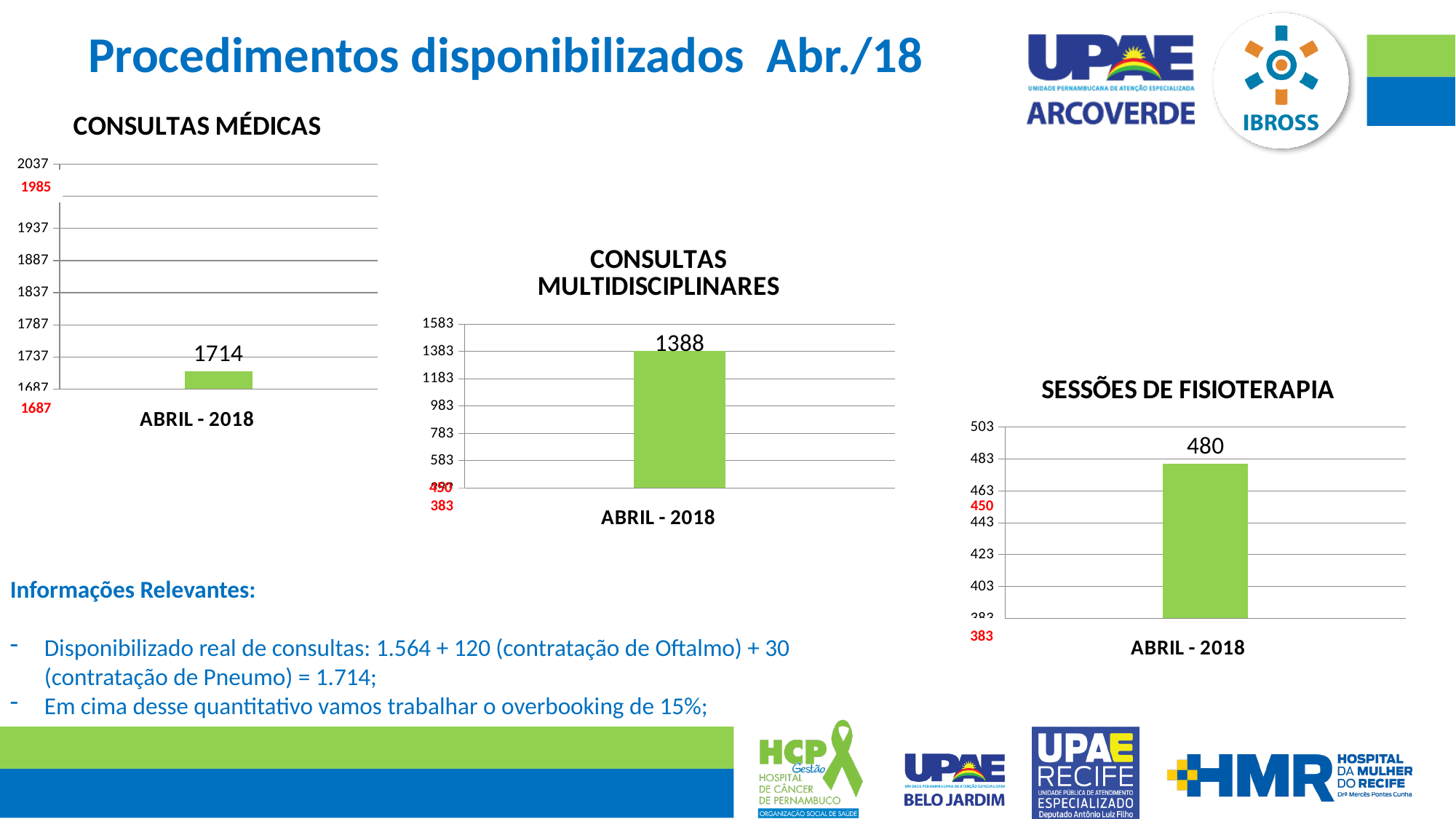
What is the difference between the ABRIL - 2018 value in the CONSULTAS MULTIDISCIPLINARES chart and the ABRIL - 2018 value in the SESSÕES DE FISIOTERAPIA chart? 908 In the CONSULTAS MULTIDISCIPLINARES chart, what is the value for ABRIL - 2018? 1388 In the SESSÕES DE FISIOTERAPIA chart, is the value for ABRIL - 2018 greater or less than 503? less How many bars are plotted in the SESSÕES DE FISIOTERAPIA chart? 1 In the CONSULTAS MULTIDISCIPLINARES chart, is the value for ABRIL - 2018 greater or less than 983? greater What is the title of the chart in the middle of the slide? CONSULTAS MULTIDISCIPLINARES Which is larger: the ABRIL - 2018 value in the CONSULTAS MÉDICAS chart or in the CONSULTAS MULTIDISCIPLINARES chart? CONSULTAS MÉDICAS What kind of chart is the CONSULTAS MÉDICAS chart? bar chart What is the category label on the x axis of the SESSÕES DE FISIOTERAPIA chart? ABRIL - 2018 What is the difference between the ABRIL - 2018 value in the CONSULTAS MÉDICAS chart and the ABRIL - 2018 value in the CONSULTAS MULTIDISCIPLINARES chart? 326 In the CONSULTAS MÉDICAS chart, what is the value for ABRIL - 2018? 1714 In the SESSÕES DE FISIOTERAPIA chart, what is the value for ABRIL - 2018? 480